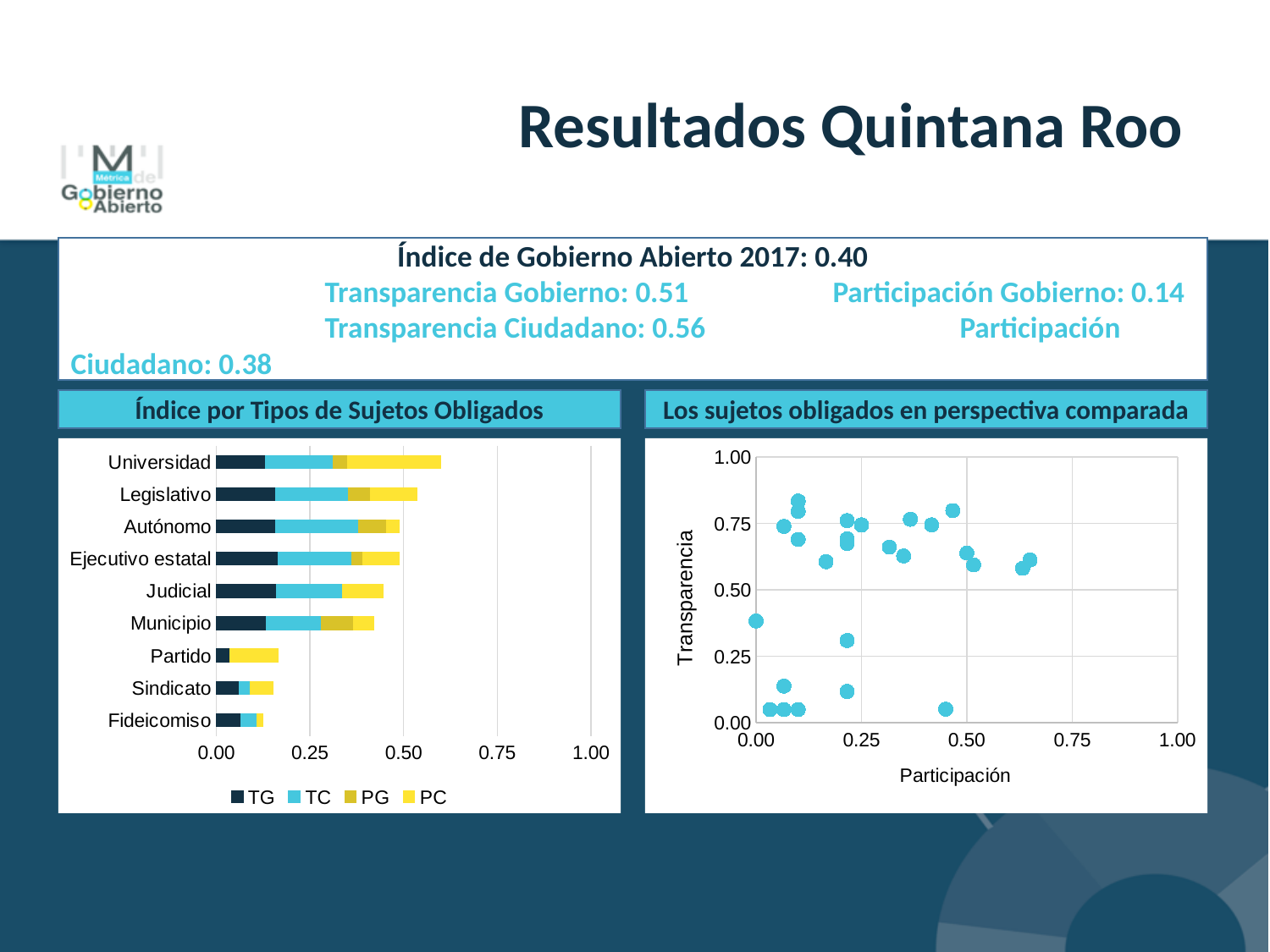
In the chart "Índice por Tipos de Sujetos Obligados", which category has the longest total bar? Universidad In the chart "Índice por Tipos de Sujetos Obligados", which has the longer total bar, Legislativo or Judicial? Legislativo In the chart "Índice por Tipos de Sujetos Obligados", what are the legend entries? TG, TC, PG, PC What kind of chart is "Los sujetos obligados en perspectiva comparada"? scatter chart In the chart "Los sujetos obligados en perspectiva comparada", what is the label of the vertical axis? Transparencia In the chart "Índice por Tipos de Sujetos Obligados", is the total bar for Partido greater or less than 0.25? less In the chart "Índice por Tipos de Sujetos Obligados", which category has the shortest total bar? Fideicomiso In the chart "Índice por Tipos de Sujetos Obligados", is the total bar for Universidad greater or less than 0.50? greater In the chart "Índice por Tipos de Sujetos Obligados", how many categories are shown on the vertical axis? 9 What kind of chart is "Índice por Tipos de Sujetos Obligados"? bar chart In the chart "Índice por Tipos de Sujetos Obligados", how many series does the legend list? 4 In the chart "Índice por Tipos de Sujetos Obligados", is the total bar for Judicial greater or less than 0.50? less